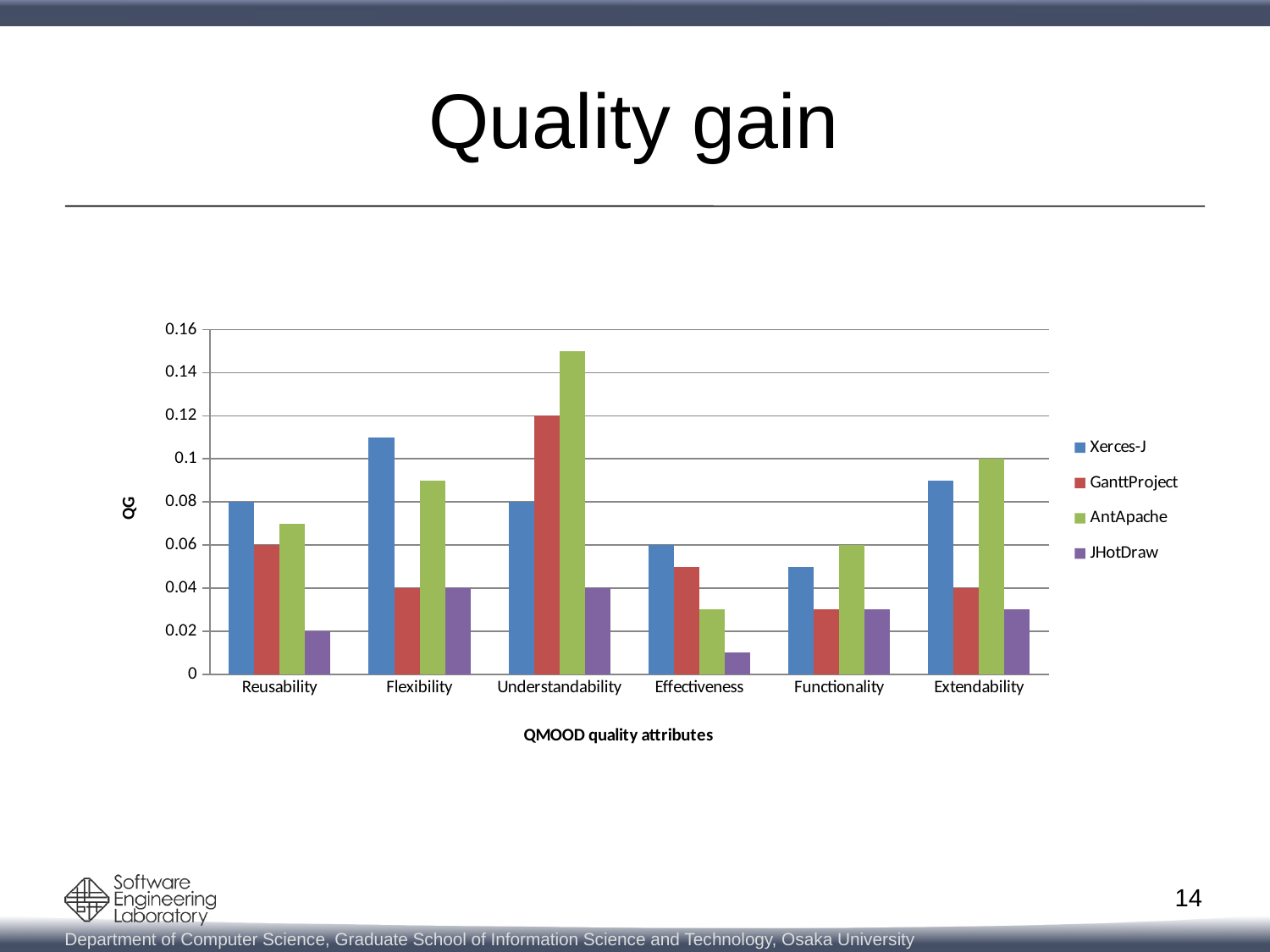
Which series has the highest QG value for Understandability? AntApache How many QMOOD quality attributes are shown on the x axis? 6 Is the QG value for Xerces-J on Flexibility greater or less than 0.1? greater What is the QG value for GanttProject on Understandability? 0.12 Is the QG value for AntApache on Understandability greater or less than 0.14? greater How many series does the legend list? 4 What is the QG value for Xerces-J on Reusability? 0.08 What is the QG value for AntApache on Extendability? 0.1 What is the label of the y axis? QG For Functionality, which is larger: the QG value for Xerces-J or for AntApache? AntApache Which series has the lowest QG value for Effectiveness? JHotDraw What kind of chart is shown on the slide? bar chart